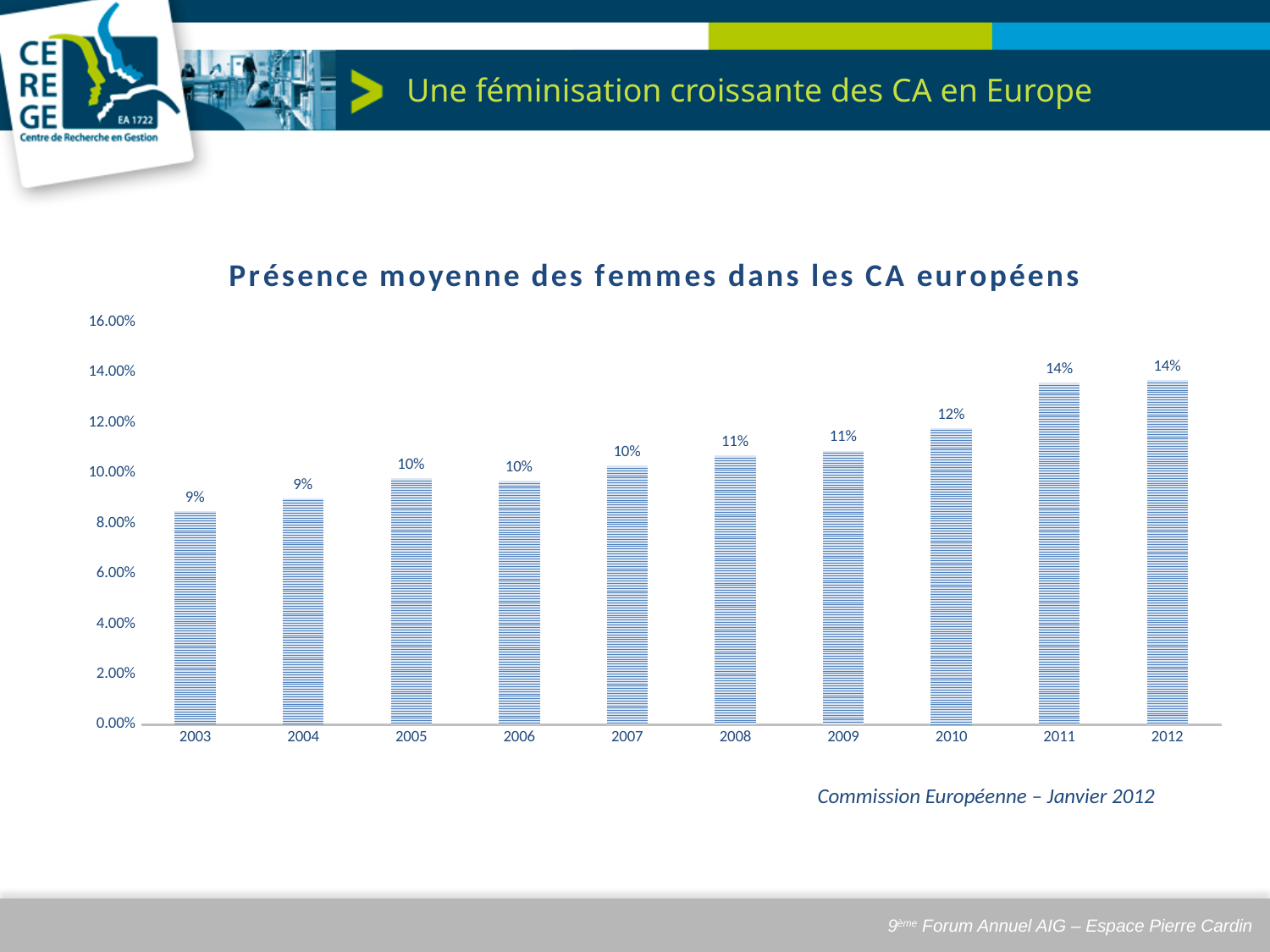
What is the value shown for 2008? 11% What is the lowest value labelled on the chart? 9% Is the value for 2003 greater or less than 10.00%? less How many years are shown on the x axis? 10 What is the highest value labelled on the chart? 14% What is the value shown for 2010? 12% Which year has the larger value, 2005 or 2010? 2010 What type of chart is shown on the slide? Bar chart What is the value shown for 2003? 9% What is the title of the chart? Présence moyenne des femmes dans les CA européens Do the values generally rise or fall from 2003 to 2012? Rise What is the difference between the value for 2012 and the value for 2003? 5 percentage points